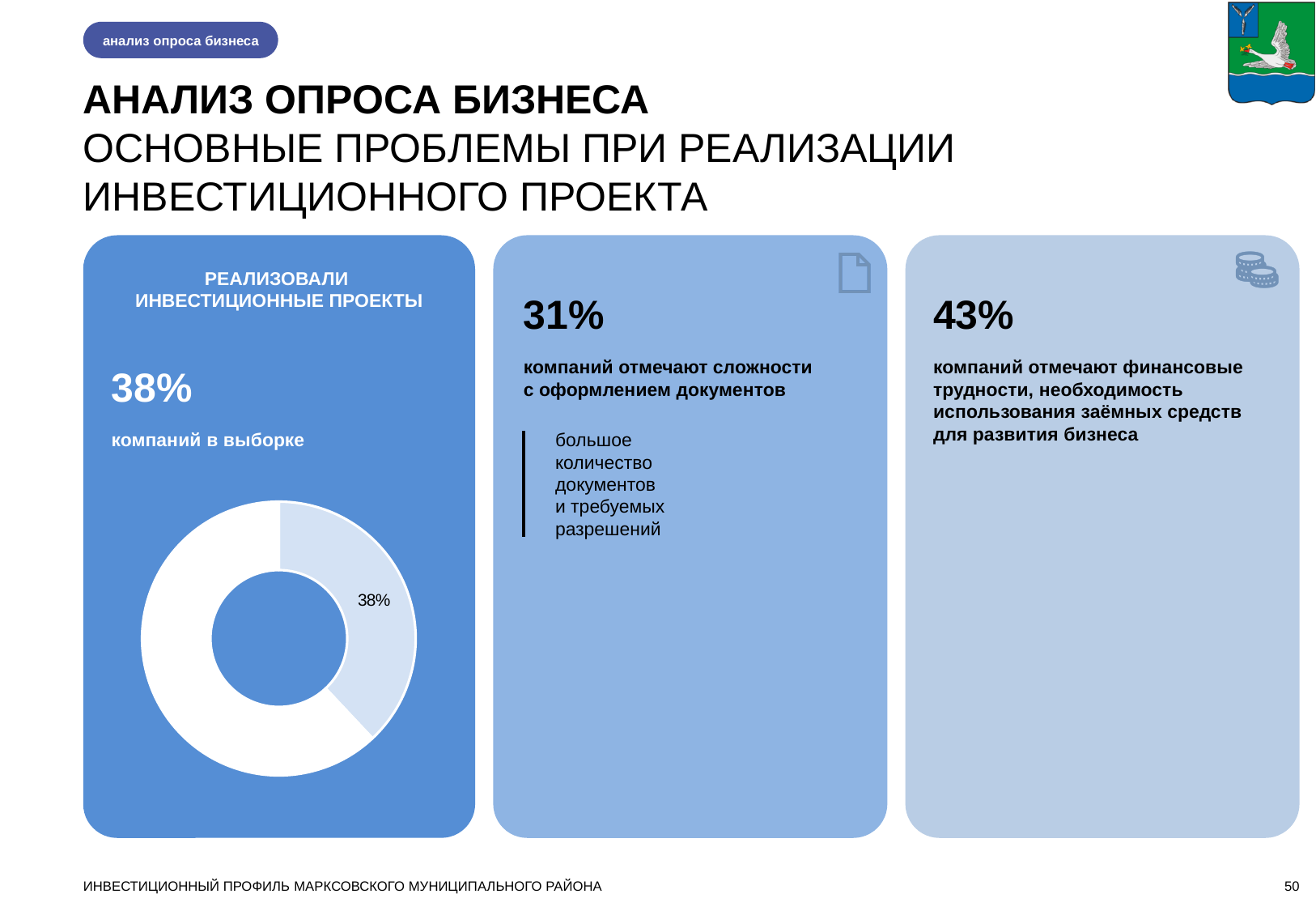
What is the heading printed above the donut chart? РЕАЛИЗОВАЛИ ИНВЕСТИЦИОННЫЕ ПРОЕКТЫ Which slice of the donut chart is larger, the labelled light-blue slice or the unlabelled white slice? The unlabelled white slice Is the labelled slice of the donut chart greater or less than 50% of the whole? less What value is printed as the data label on the donut chart? 38% What text is printed below the large 38% figure above the donut chart? компаний в выборке What share of the donut chart does the labelled light-blue slice represent? 38% What kind of chart is shown on the slide? Pie (donut) chart How many slices does the donut chart have? 2